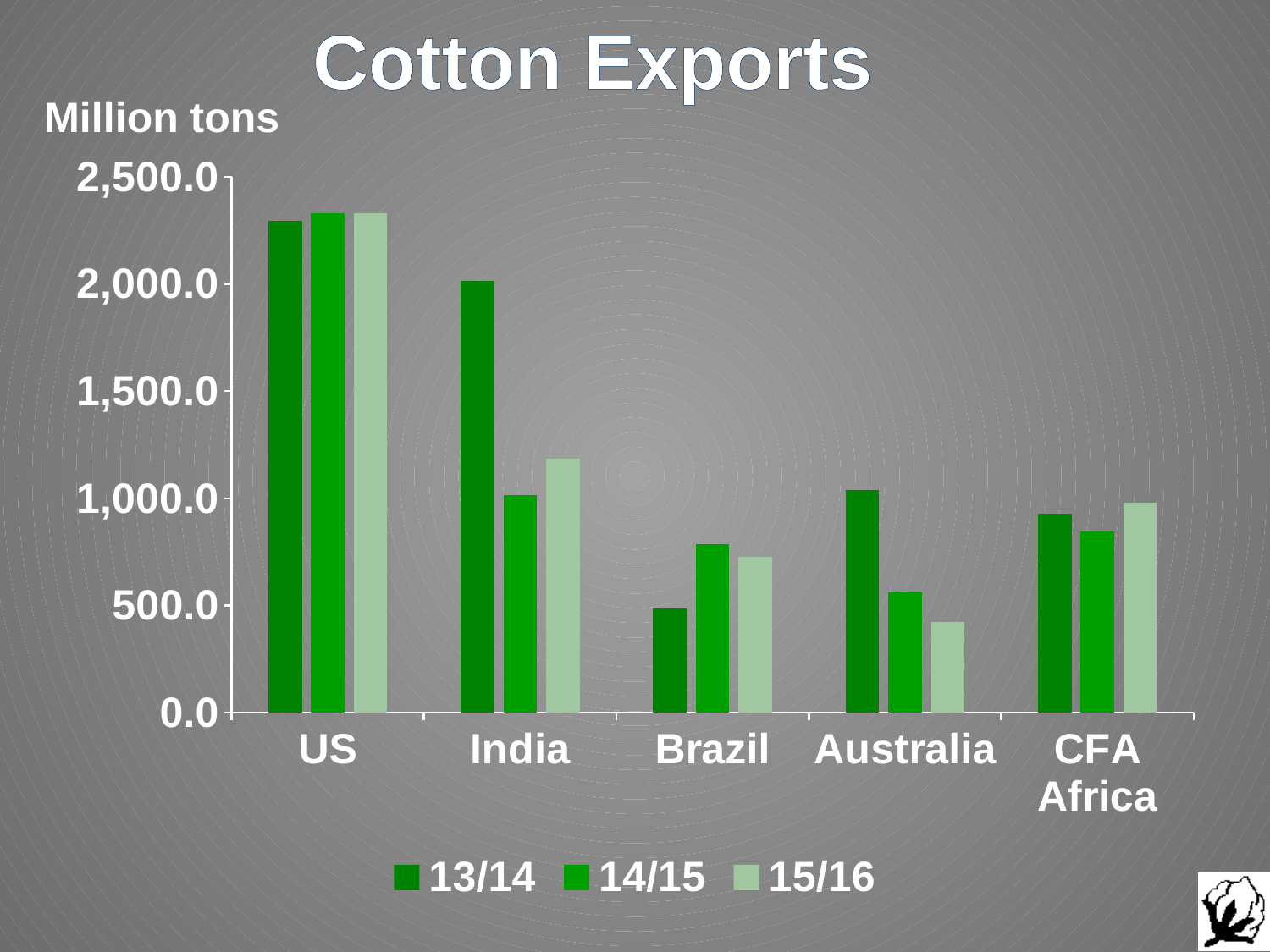
How many series does the legend list? 3 Is the value for India in 15/16 greater or less than 1,000.0? greater Which is larger for India: the 13/14 value or the 14/15 value? 13/14 Is the value for US in 13/14 greater or less than 2,000.0? greater Is the value for Australia in 15/16 greater or less than 500.0? less Do Australia's cotton exports rise or fall from 13/14 to 15/16? fall How many countries or regions are shown on the x axis? 5 Which country has the highest cotton exports in 13/14? US What unit is given for the y axis? Million tons Which country has the lowest cotton exports in 13/14? Brazil What kind of chart is shown on the slide? bar chart Which country has the lowest cotton exports in 15/16? Australia